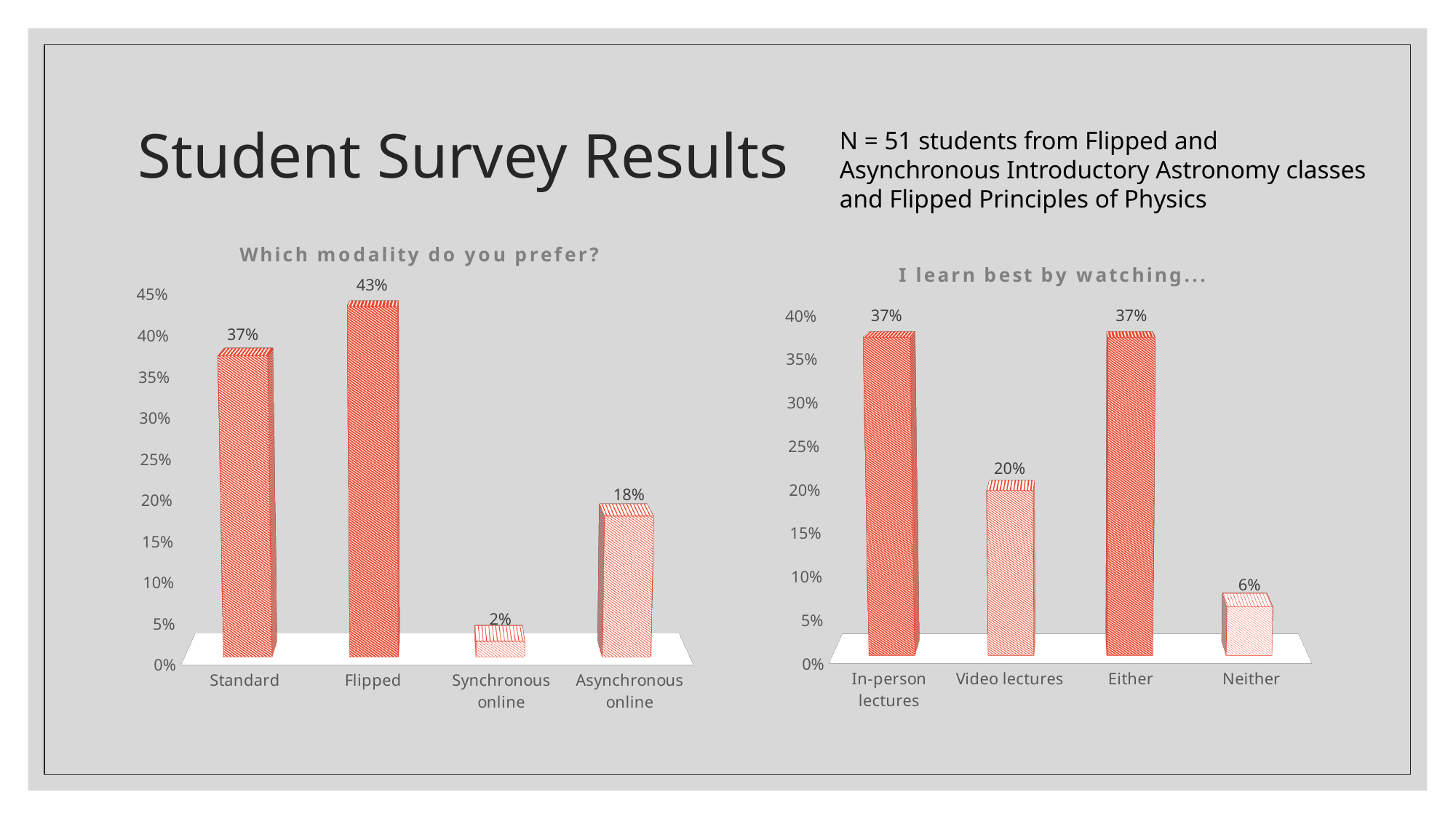
In the 'Which modality do you prefer?' chart, what is the difference between Flipped and Standard? 6% In the 'I learn best by watching...' chart, which is larger, Video lectures or Either? Either In the 'I learn best by watching...' chart, what is the difference between In-person lectures and Video lectures? 17% In the 'I learn best by watching...' chart, which category has the lowest value? Neither In the 'I learn best by watching...' chart, what is the value for Neither? 6% In the 'Which modality do you prefer?' chart, which category has the lowest value? Synchronous online What kind of chart is the 'I learn best by watching...' chart? Bar chart In the 'I learn best by watching...' chart, what is the value for Video lectures? 20% In the 'Which modality do you prefer?' chart, what is the value for Flipped? 43% In the 'Which modality do you prefer?' chart, what is the value for Synchronous online? 2% In the 'Which modality do you prefer?' chart, which category has the highest value? Flipped In the 'Which modality do you prefer?' chart, how many categories are shown? 4